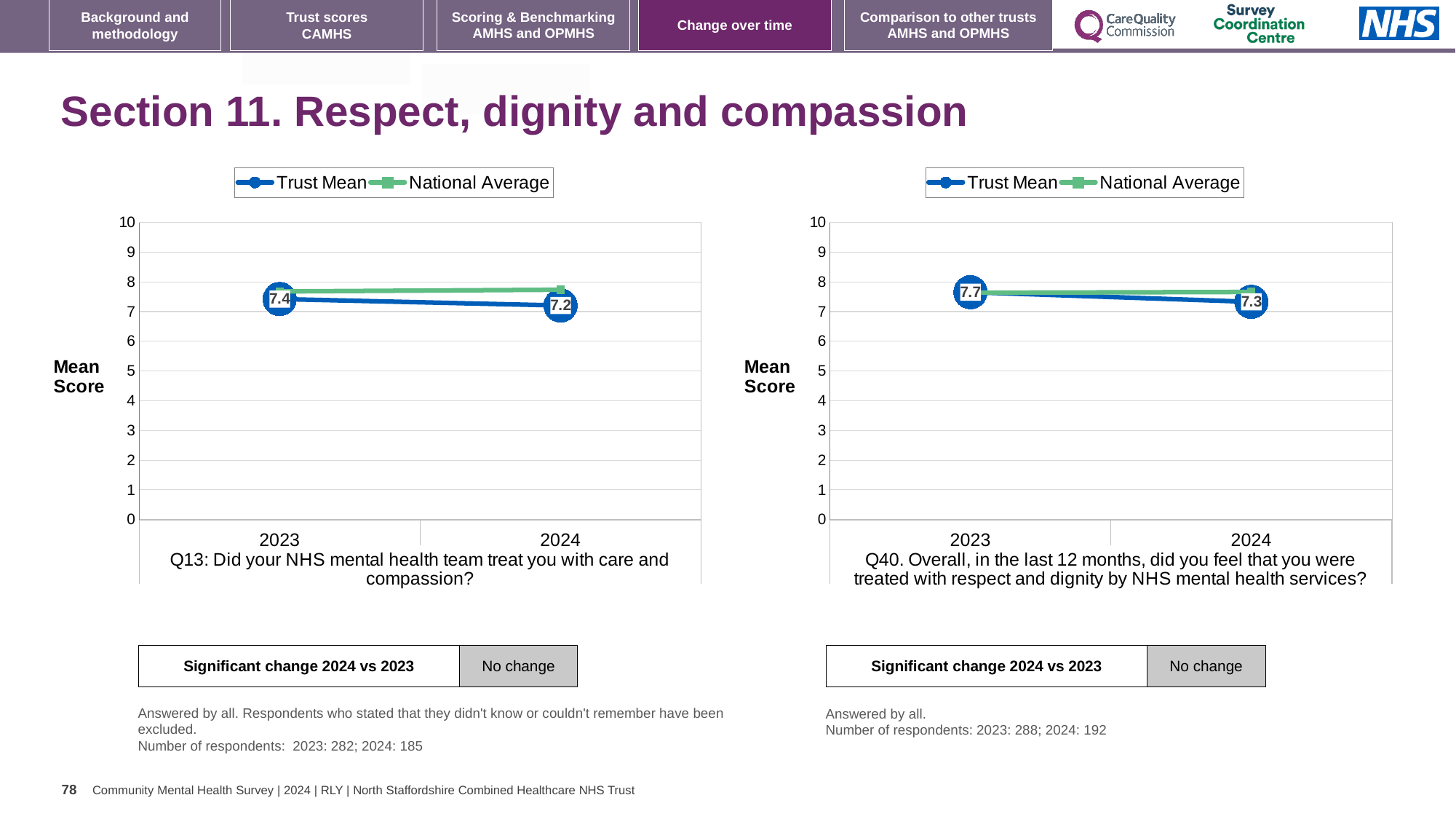
What kind of chart is used on the right (Q40)? line chart How many series does the legend of the left chart (Q13) list? 2 In the right chart (Q40), what is the Trust Mean score for 2023? 7.7 In the left chart (Q13), what is the difference between the Trust Mean in 2023 and 2024? 0.2 How many years are plotted on the x axis of the right chart (Q40)? 2 In the left chart (Q13), does the Trust Mean rise or fall from 2023 to 2024? fall In the left chart (Q13), what is the Trust Mean score for 2023? 7.4 In the left chart (Q13), which series has the higher value in 2024, Trust Mean or National Average? National Average In the left chart (Q13), what is the Trust Mean score for 2024? 7.2 In the right chart (Q40), what is the Trust Mean score for 2024? 7.3 In the right chart (Q40), is the National Average value for 2023 greater or less than 5? greater In the right chart (Q40), by how much did the Trust Mean fall from 2023 to 2024? 0.4